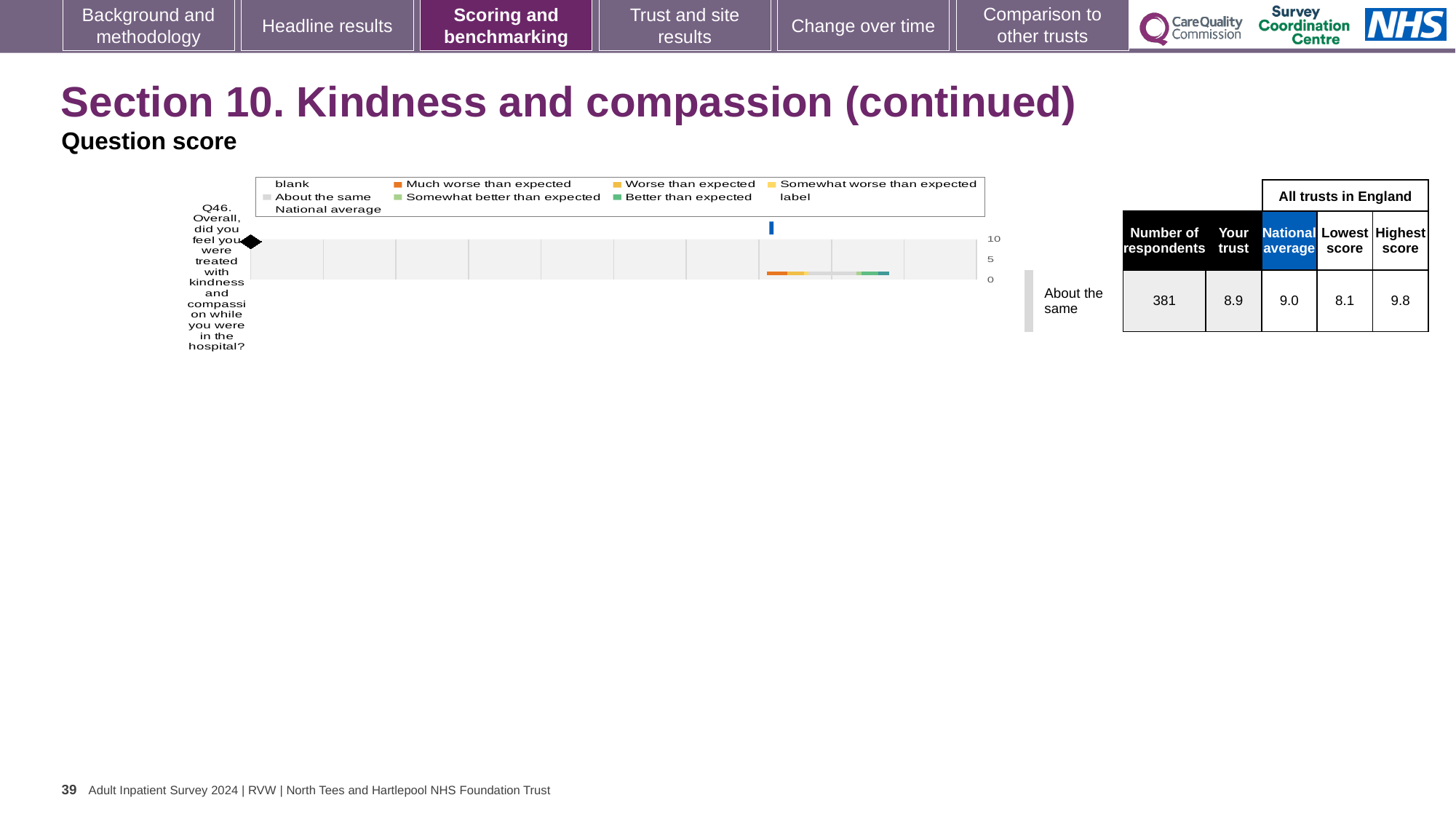
Which survey question does the chart on the slide relate to? Q46. Overall, did you feel you were treated with kindness and compassion while you were in the hospital? What is the highest score among all trusts in England for Q46? 9.8 How many entries does the chart legend list? 9 What is the difference between the highest score and the lowest score for Q46? 1.7 Which is larger for Q46: the trust's score or the national average? National average What is the national average score for Q46 shown on the slide? 9.0 How many respondents answered Q46 for this trust? 381 What kind of chart is shown on the slide for Q46? bar chart What is the 'Your trust' score for Q46 shown on the slide? 8.9 What is the difference between the national average and the trust's score for Q46? 0.1 What is the lowest score among all trusts in England for Q46? 8.1 Which benchmarking category is the trust's Q46 result placed in? About the same